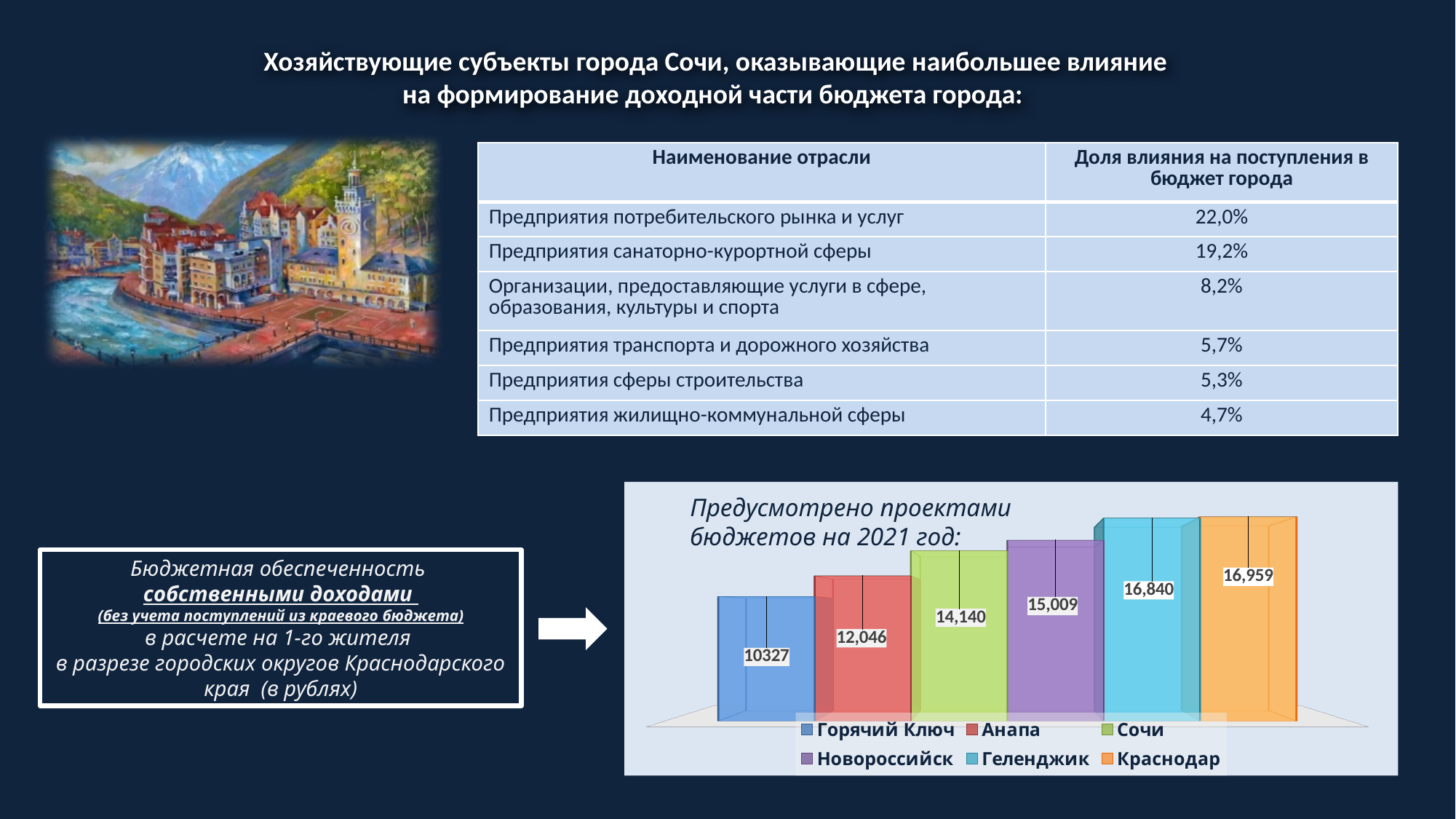
What is the value for Новороссийск in the chart? 15,009 What is the difference between the values for Сочи and Анапа? 2,094 Do the values rise or fall from left to right across the bars? rise What is the value for Горячий Ключ in the chart? 10327 Which is larger, the value for Новороссийск or the value for Анапа? Новороссийск What is the value for Сочи in the chart? 14,140 What kind of chart is shown on the slide? bar chart What is the difference between the values for Краснодар and Геленджик? 119 Which city has the lowest value in the chart? Горячий Ключ Which city has the highest value in the chart? Краснодар What is the value for Геленджик in the chart? 16,840 How many cities are shown in the chart? 6